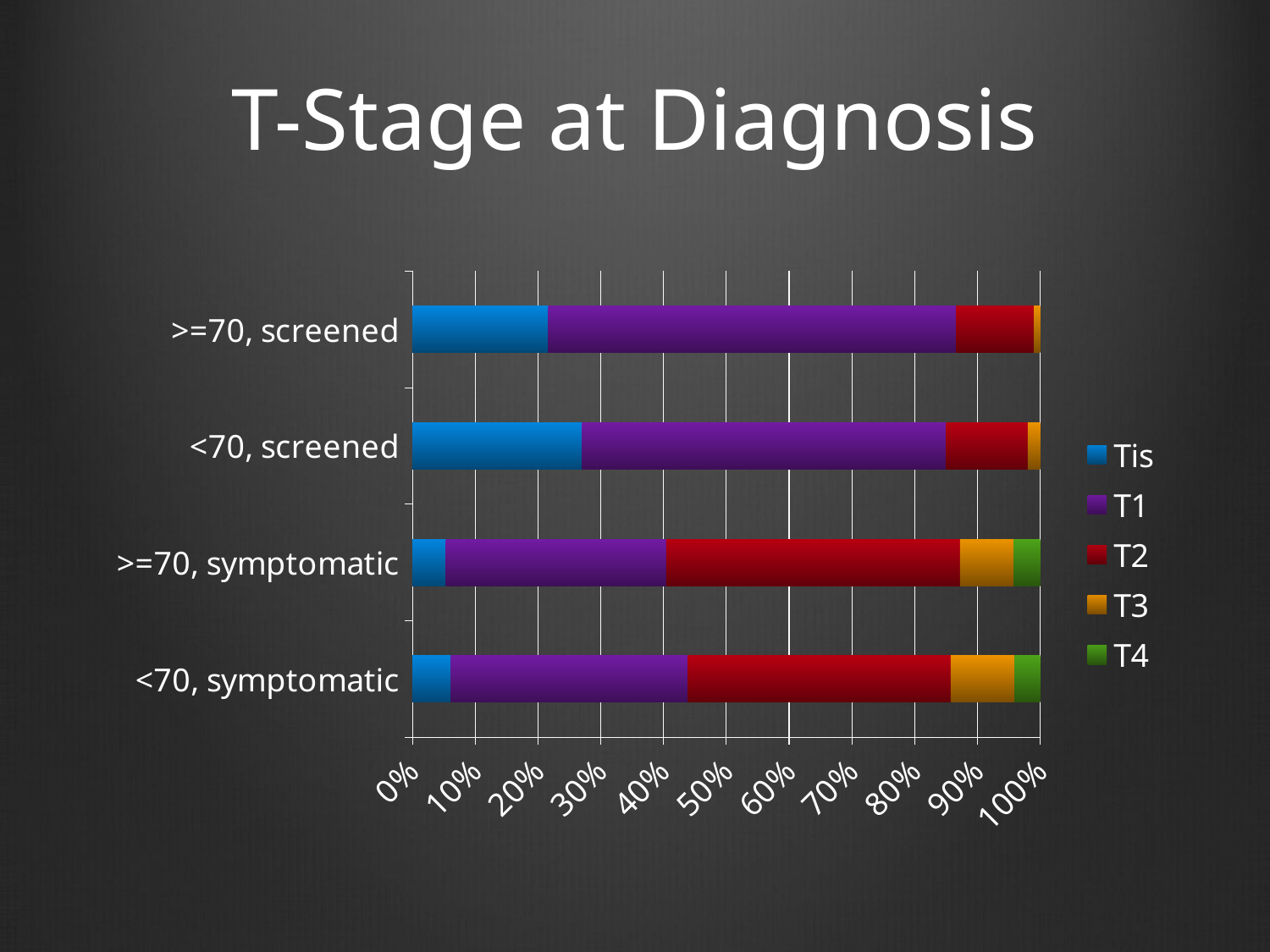
How many series does the legend list? 5 Which group has the largest T1 segment? >=70, screened What kind of chart is shown on the slide? Stacked bar chart What does each stacked bar total on the x axis? 100% Is the Tis share for the '<70, screened' group greater or less than 20%? greater Which has the larger T2 share: '>=70, screened' or '>=70, symptomatic'? >=70, symptomatic Is the T1 share for the '>=70, screened' group greater or less than 50%? greater Is the Tis share for the '>=70, symptomatic' group greater or less than 10%? less Which group has the largest Tis segment? <70, screened What is the title of the chart? T-Stage at Diagnosis Which series is shown in green in the legend? T4 How many patient groups (categories) are plotted on the chart? 4